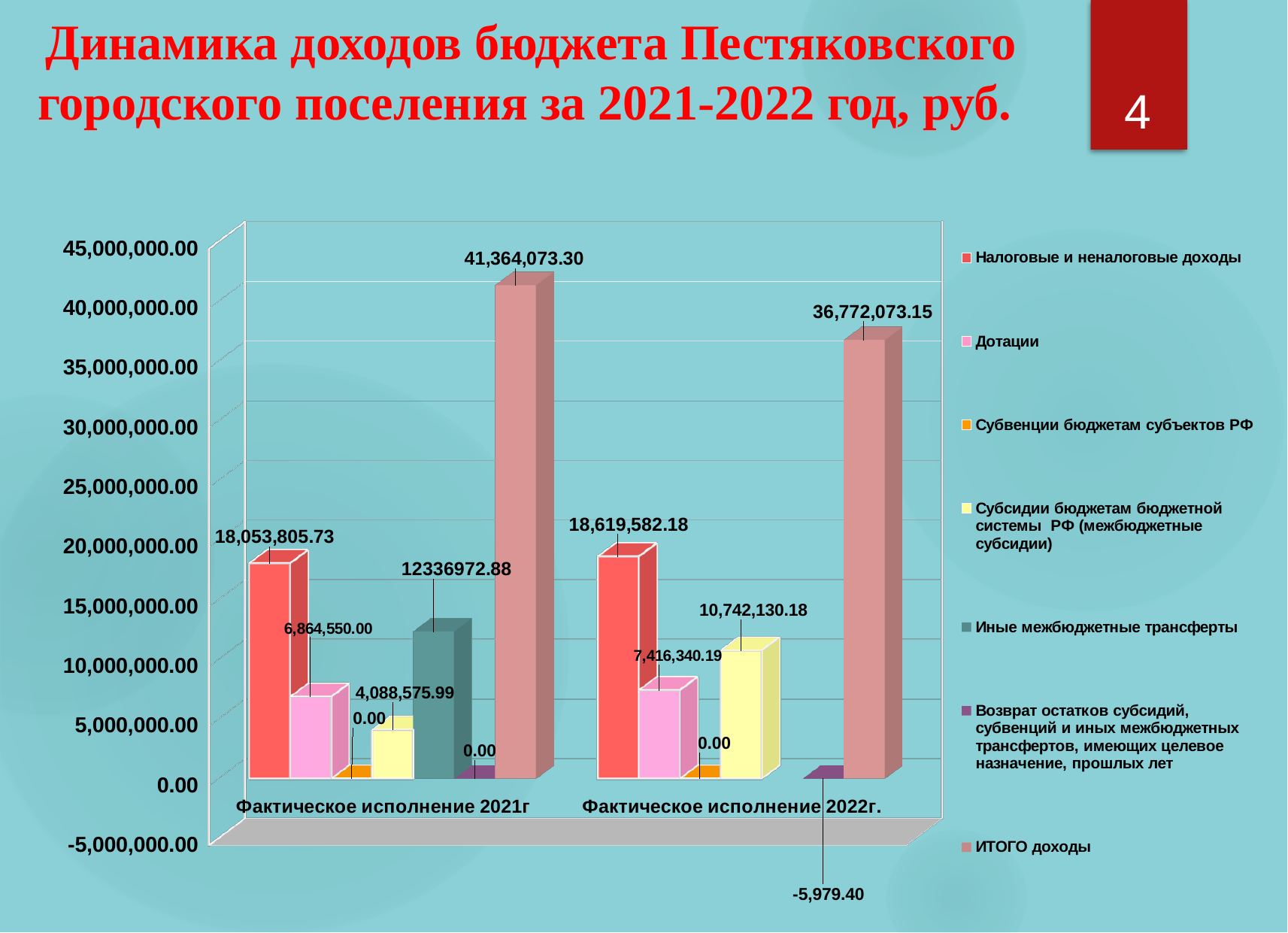
What kind of chart is shown on the slide? Bar chart Which is larger: Дотации for Фактическое исполнение 2021г or for Фактическое исполнение 2022г.? Фактическое исполнение 2022г. What is the difference between ИТОГО доходы for 2021 and for 2022? 4,592,000.15 Which series has the highest value for Фактическое исполнение 2021г? ИТОГО доходы What is the value of Дотации for Фактическое исполнение 2021г? 6,864,550.00 What is the value of Возврат остатков субсидий, субвенций и иных межбюджетных трансфертов for Фактическое исполнение 2022г.? -5,979.40 How many series does the legend list? 7 What is the value of ИТОГО доходы for Фактическое исполнение 2021г? 41,364,073.30 What is the value of ИТОГО доходы for Фактическое исполнение 2022г.? 36,772,073.15 Does the value of ИТОГО доходы rise or fall from 2021 to 2022? Fall What is the value of Налоговые и неналоговые доходы for Фактическое исполнение 2022г.? 18,619,582.18 What is the value of Субсидии бюджетам бюджетной системы РФ (межбюджетные субсидии) for Фактическое исполнение 2022г.? 10,742,130.18